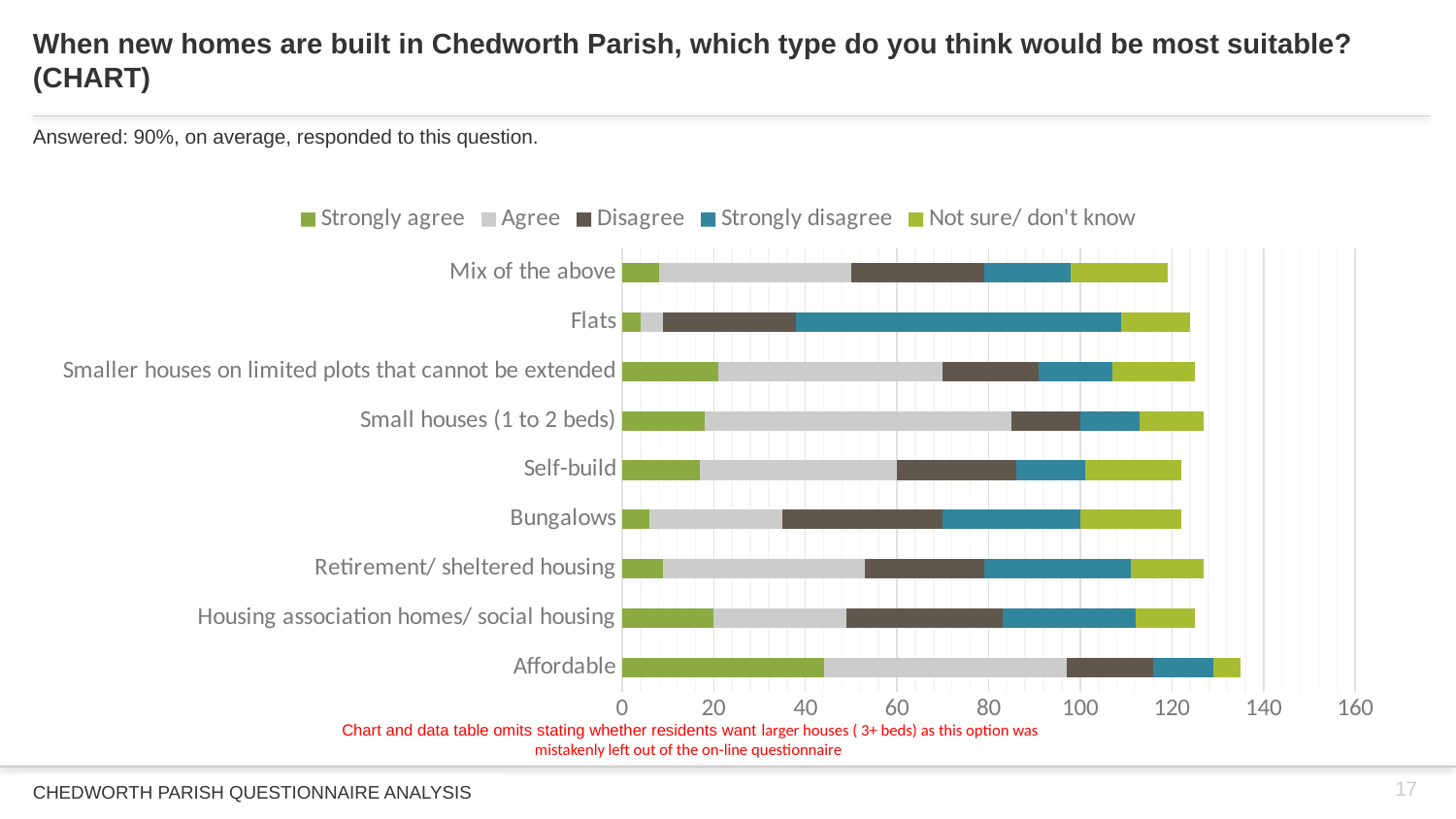
What kind of chart is shown on the slide? Stacked bar chart Which category has the largest "Strongly disagree" segment? Flats How many series does the chart legend list? 5 Which category is listed at the bottom of the chart, nearest the x axis? Affordable Is the total stacked bar for Affordable greater or less than 120? greater Is the "Strongly agree" value for Affordable greater or less than 20? greater How many housing type categories are plotted on the chart? 9 Is the "Strongly agree" value for Flats greater or less than 20? less Which category has the largest "Strongly agree" segment? Affordable Which has the larger "Strongly agree" segment: Affordable or Bungalows? Affordable Which response option is shown in the legend between "Agree" and "Strongly disagree"? Disagree Which category has the longest total stacked bar? Affordable